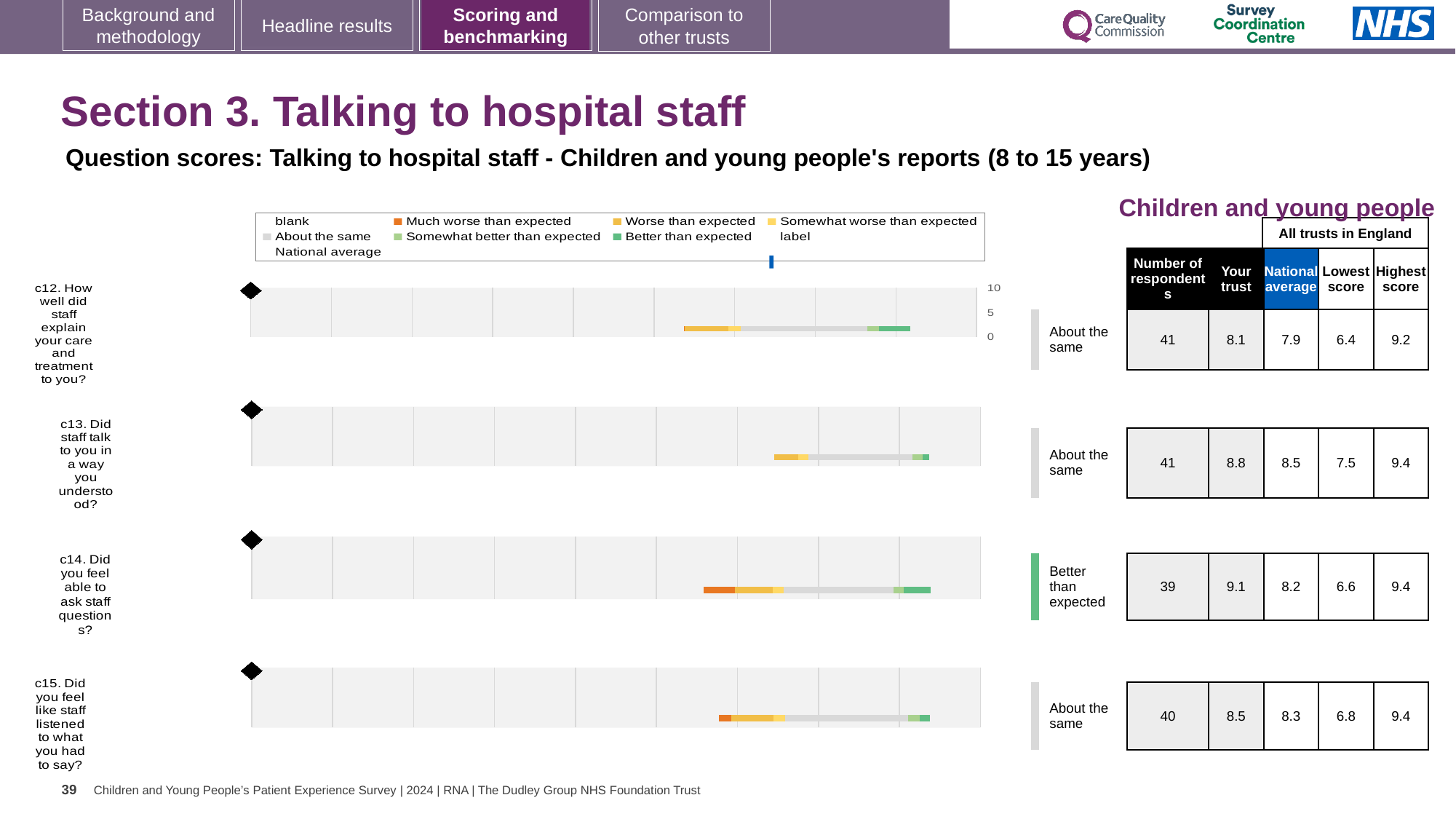
Which question has the lowest 'Your trust' score? c12 What is the highest score across all trusts in England for c13 (Did staff talk to you in a way you understood?)? 9.4 What benchmark category is shown next to the chart for c14? Better than expected What is the difference between the 'Your trust' score and the national average for c14? 0.9 In the table, what is the national average for c12 (How well did staff explain your care and treatment to you?)? 7.9 What kind of chart is used to show each question's results? Bar chart For c13, which is larger: the 'Your trust' score or the national average? Your trust What is the lowest score across all trusts in England for c12? 6.4 In the table, what is the 'Your trust' score for c14 (Did you feel able to ask staff questions?)? 9.1 How many respondents are listed for c15 (Did you feel like staff listened to what you had to say?)? 40 How many questions are charted on this slide? 4 Which question has the highest 'Your trust' score? c14